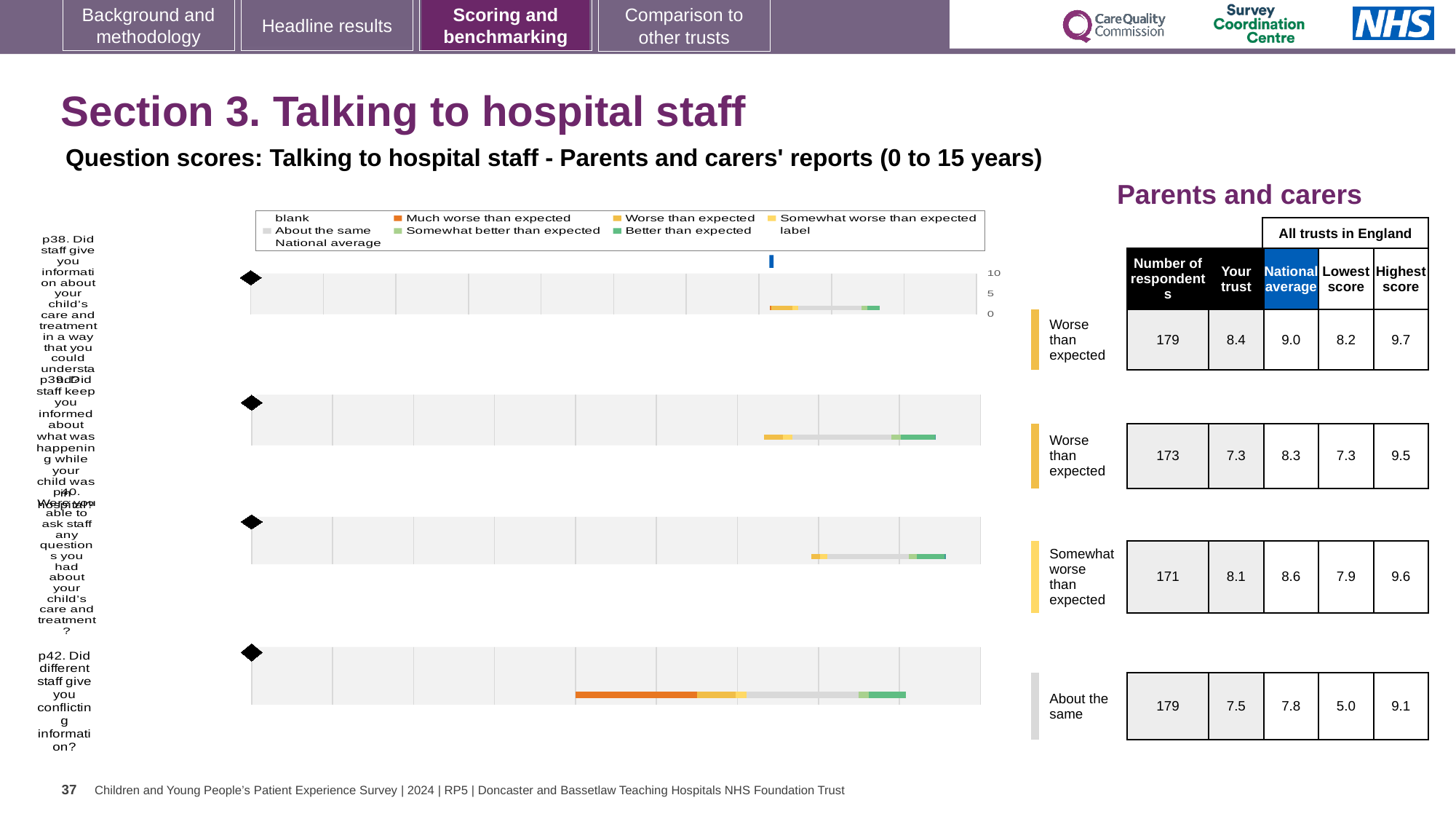
Which of the four questions has the highest 'Your trust' score? p38 For p38 (staff giving information about your child's care in a way you could understand), what is the 'Your trust' score? 8.4 What kind of chart is used to show the benchmarking results for each question on this slide? bar chart For p39 (staff keeping you informed about what was happening while your child was in hospital), what is the national average score? 8.3 What benchmark category is shown for p40? Somewhat worse than expected Which of the four questions has the lowest 'Your trust' score? p39 How many respondents answered p39? 173 How many question charts (p38, p39, p40, p42) are shown on the slide? 4 For p42 (different staff giving conflicting information), what is the lowest score among all trusts in England? 5.0 Which has the higher 'Your trust' score: p38 or p40? p38 For p40 (being able to ask staff questions about your child's care and treatment), what is the highest score among all trusts in England? 9.6 For p38, what is the difference between the national average and the 'Your trust' score? 0.6